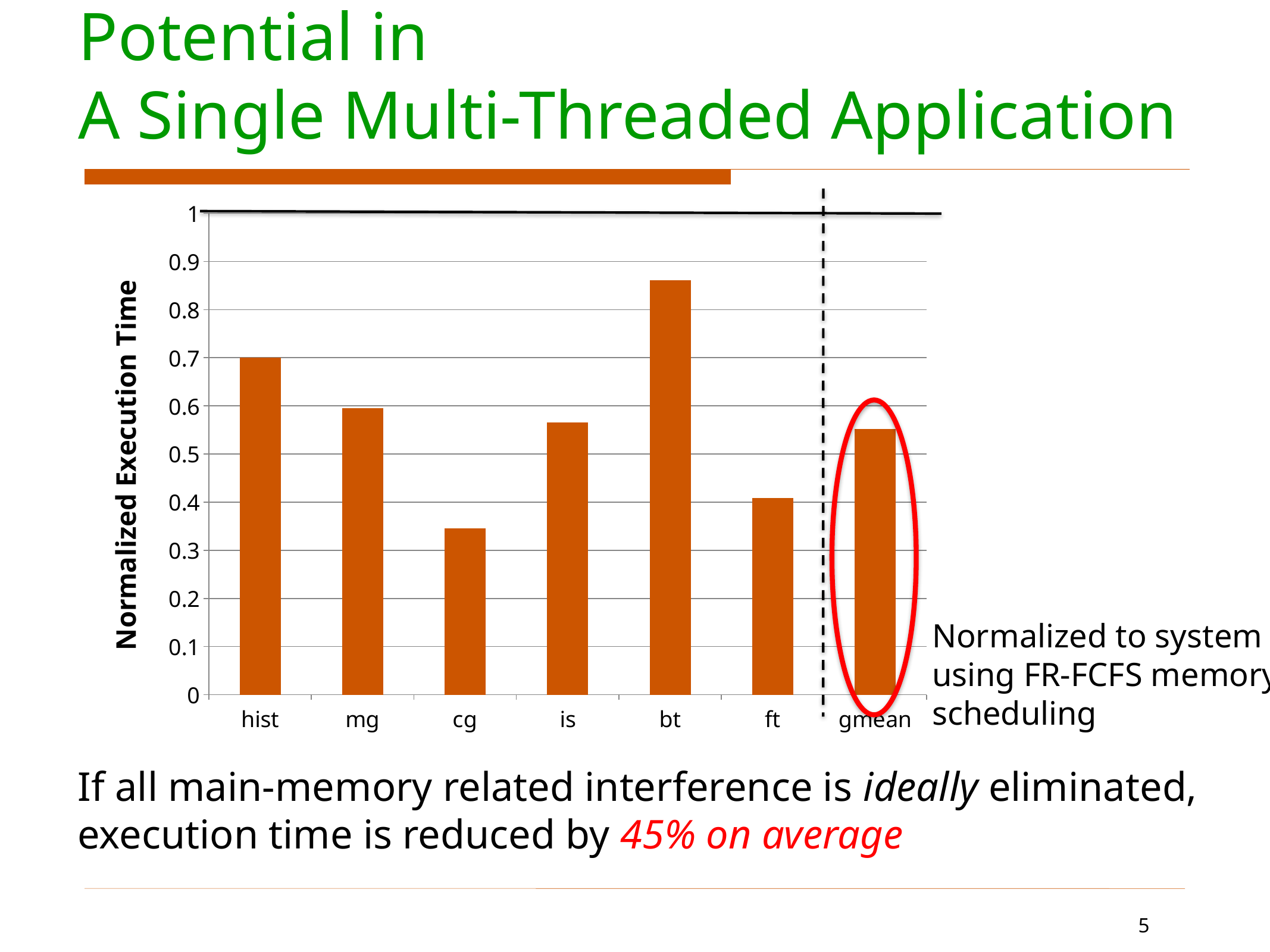
Which has a larger normalized execution time, hist or mg? hist What is the label of the y axis? Normalized Execution Time Which category has the highest normalized execution time? bt Is the value for ft greater or less than 0.5? less Which has a larger normalized execution time, cg or ft? ft What kind of chart is shown on the slide? bar chart Which category's bar is circled in red? gmean Is the value for cg greater or less than 0.4? less How many categories are plotted along the x axis? 7 Is the value for bt greater or less than 0.8? greater Which category has the lowest normalized execution time? cg